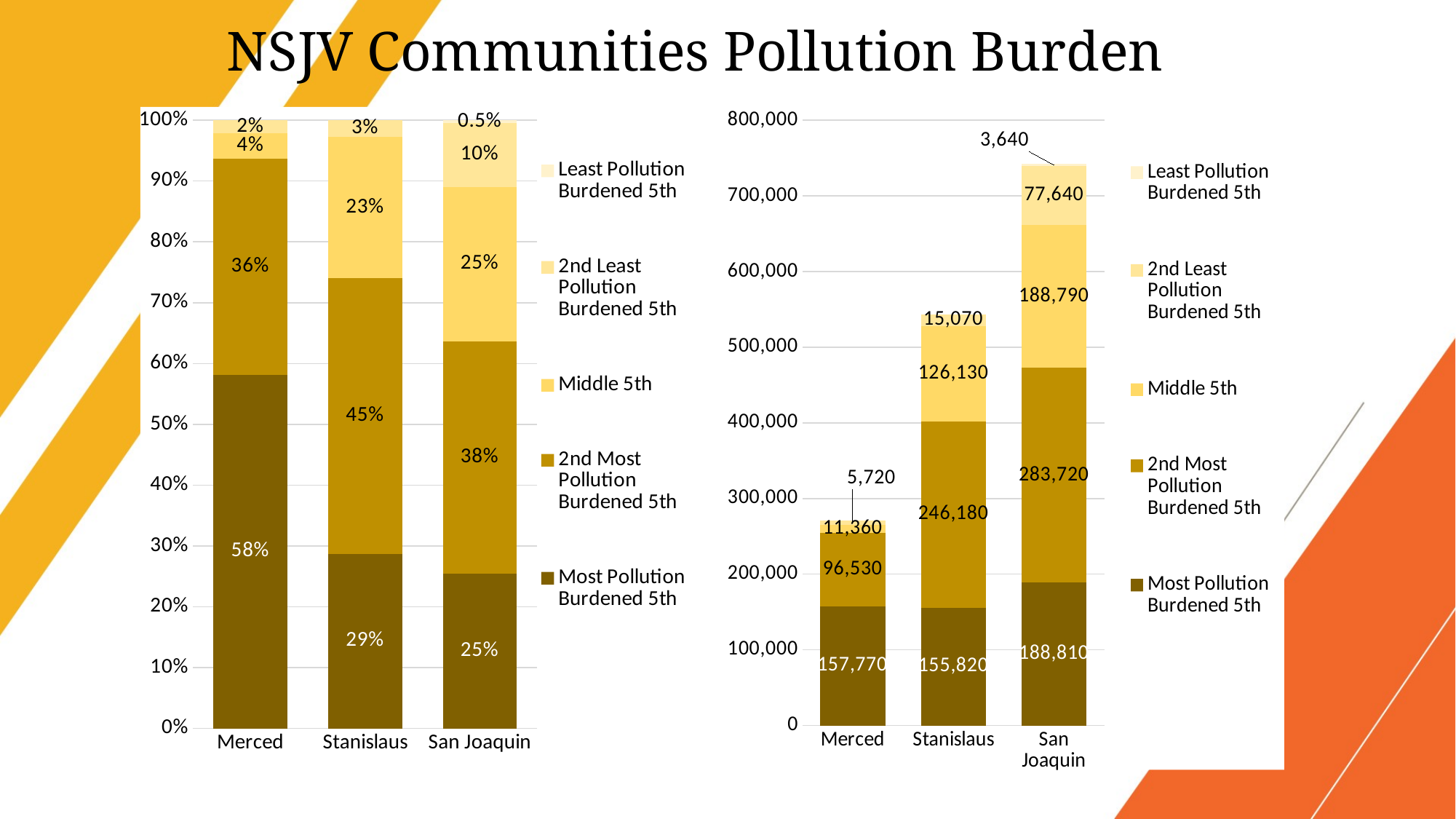
In the left chart, what percentage of Stanislaus is in the 2nd Most Pollution Burdened 5th? 45% How many series does the legend of the right chart list? 5 In the left chart, what percentage of Merced is in the Most Pollution Burdened 5th? 58% In the right chart, is the total for Merced greater or less than 300,000? less What kind of chart is the left chart? Stacked bar chart In the left chart, which community has the highest share in the Most Pollution Burdened 5th? Merced In the right chart, which community has the tallest stacked bar? San Joaquin In the right chart, what is the value for the Middle 5th in Stanislaus? 126,130 In the right chart, what is the total of the stacked bar for Stanislaus? 543,200 In the right chart, what is the value for the Most Pollution Burdened 5th in San Joaquin? 188,810 In the left chart, what is the difference between the 2nd Most Pollution Burdened 5th shares of Stanislaus and Merced? 9% In the left chart, what percentage of San Joaquin is in the Least Pollution Burdened 5th? 0.5%